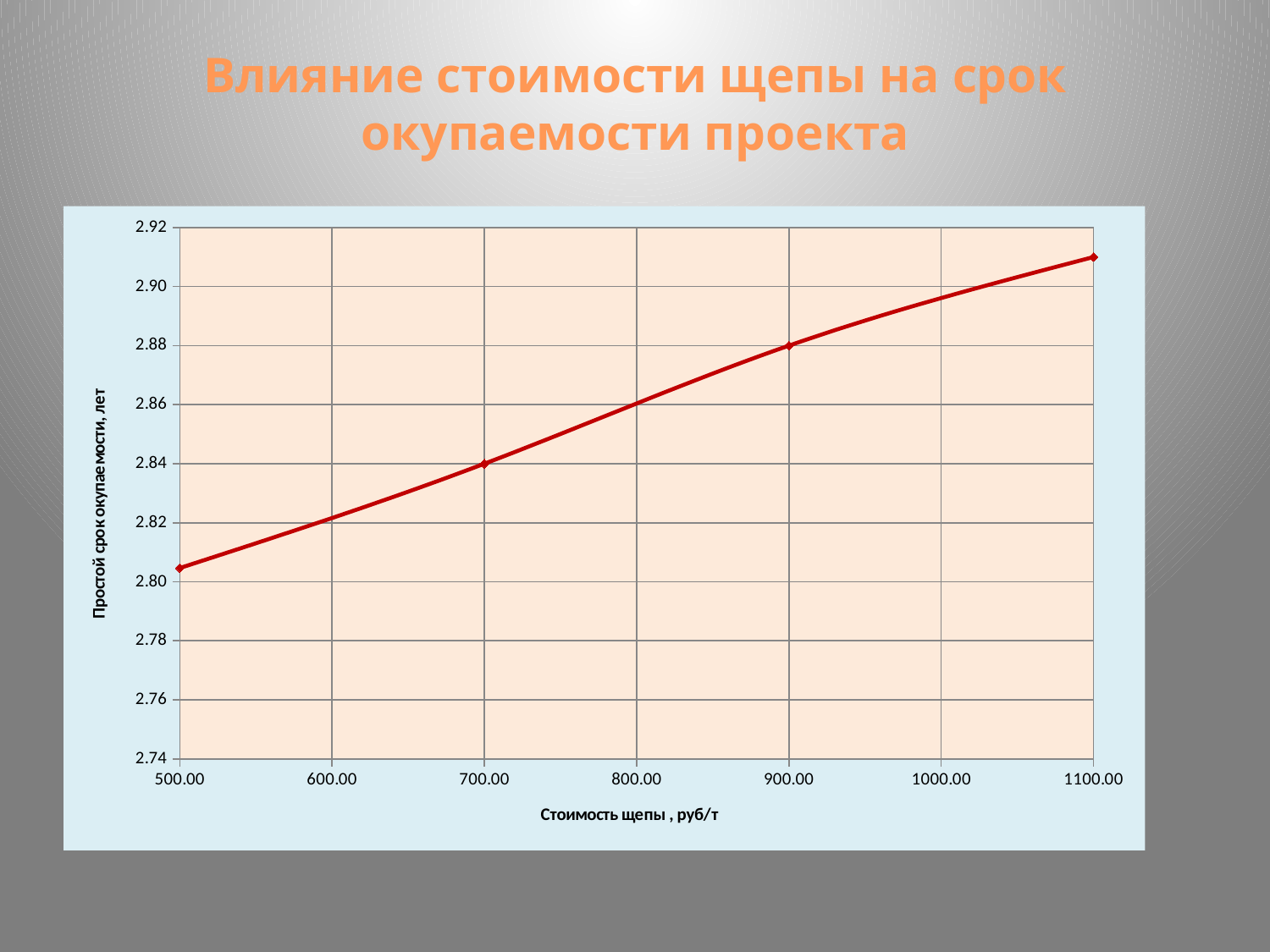
What is the payback period at a chip cost of 900.00 руб/т? 2.88 Is the payback period at a chip cost of 500.00 руб/т greater or less than 2.82? less What kind of chart is shown on the slide? line chart How many data points are marked on the line? 4 Does the payback period rise or fall as the chip cost increases along the x axis? rise What is the payback period (Простой срок окупаемости) at a chip cost of 700.00 руб/т? 2.84 At which chip cost is the payback period highest? 1100.00 What is the difference in payback period between a chip cost of 900.00 and 700.00 руб/т? 0.04 At which chip cost is the payback period lowest? 500.00 Is the payback period at a chip cost of 1100.00 руб/т greater or less than 2.90? greater What is the label of the x axis? Стоимость щепы , руб/т Which has the larger payback period: a chip cost of 700.00 or 900.00 руб/т? 900.00